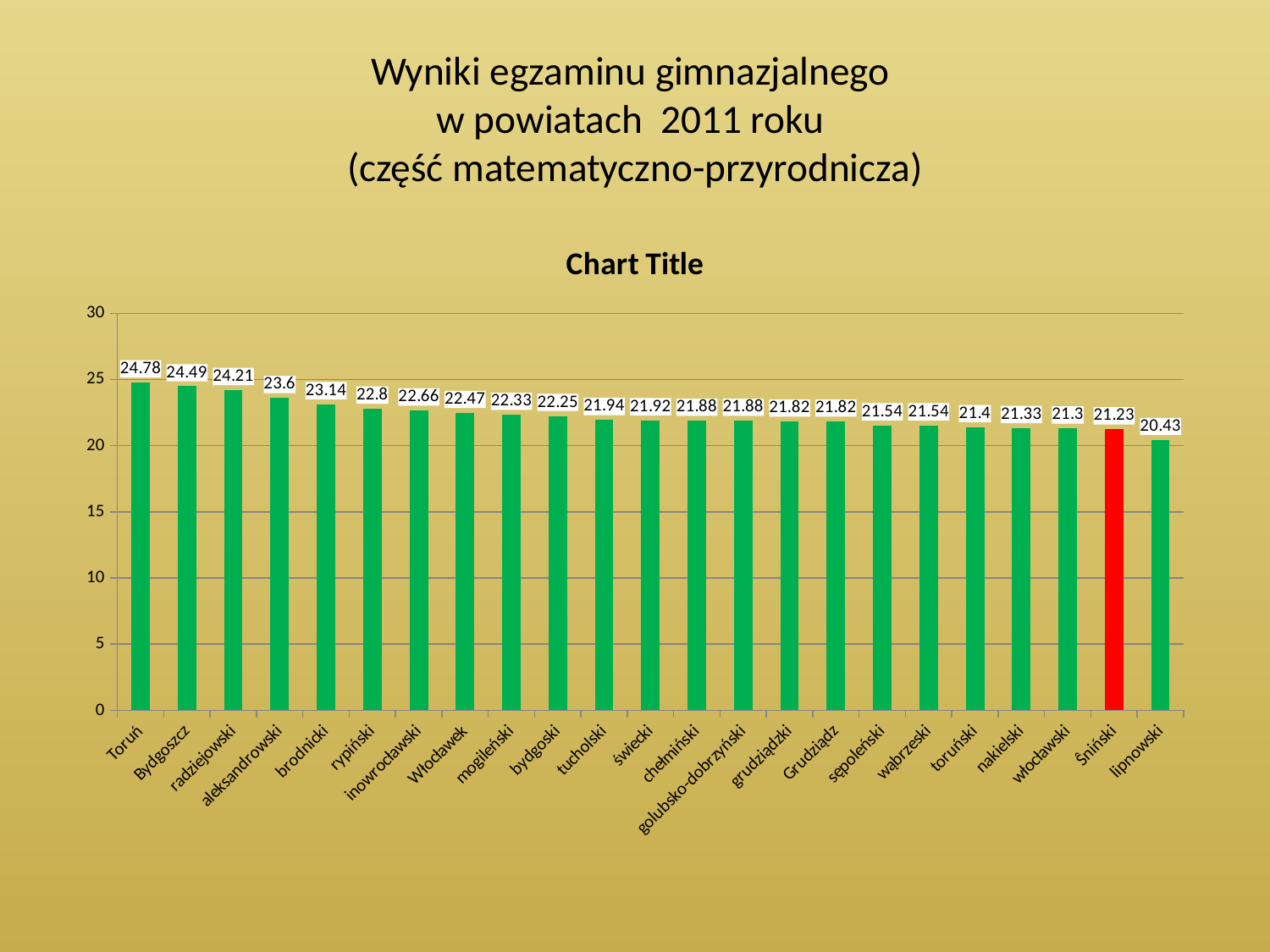
How many categories are plotted in the chart? 23 Which category has the lowest value? lipnowski Which is larger, the value for aleksandrowski or the value for rypiński? aleksandrowski What is the difference between the values for Bydgoszcz and Włocławek? 2.02 What is the value for the bar shown in red (żniński)? 21.23 Which category has the highest value? Toruń What is the value for Toruń? 24.78 What is the value for brodnicki? 23.14 What is the value for lipnowski? 20.43 What is the difference between the values for Toruń and lipnowski? 4.35 Do the values rise or fall from left to right along the x axis? fall What kind of chart is shown on the slide? bar chart